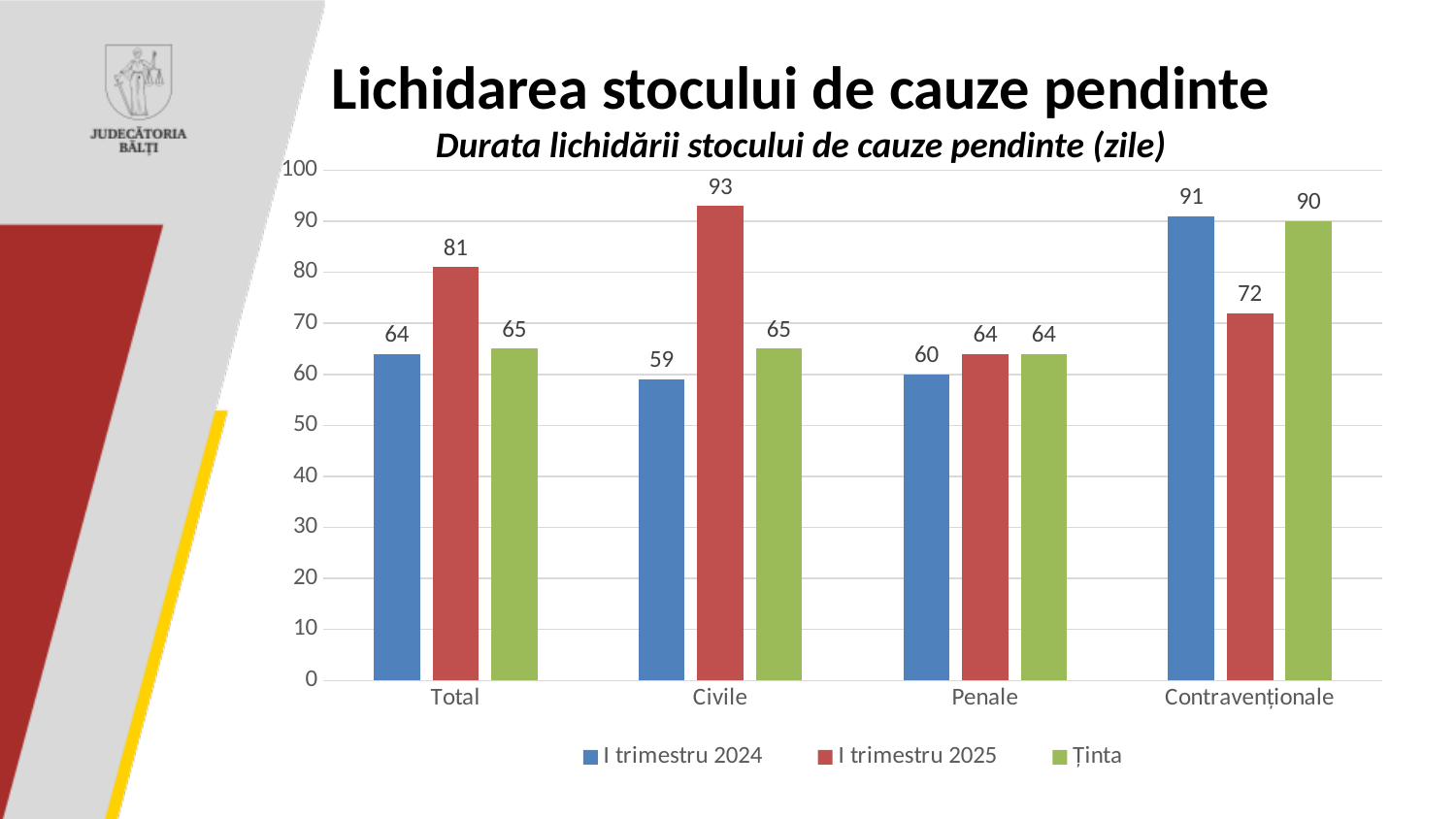
How many series does the legend list? 3 What is the difference between the I trimestru 2025 and I trimestru 2024 values for Total? 17 For Contravenționale, which is larger: the I trimestru 2024 value or the I trimestru 2025 value? I trimestru 2024 What is the subtitle of the chart? Durata lichidării stocului de cauze pendinte (zile) What kind of chart is shown on the slide? Bar chart Which category has the lowest value in the I trimestru 2024 series? Civile What colour are the Ținta bars? Green Which category has the highest value in the I trimestru 2025 series? Civile What is the value for Civile in the I trimestru 2025 series? 93 What is the value for Penale in the I trimestru 2024 series? 60 What is the Ținta value for Contravenționale? 90 How many categories are shown on the x axis? 4